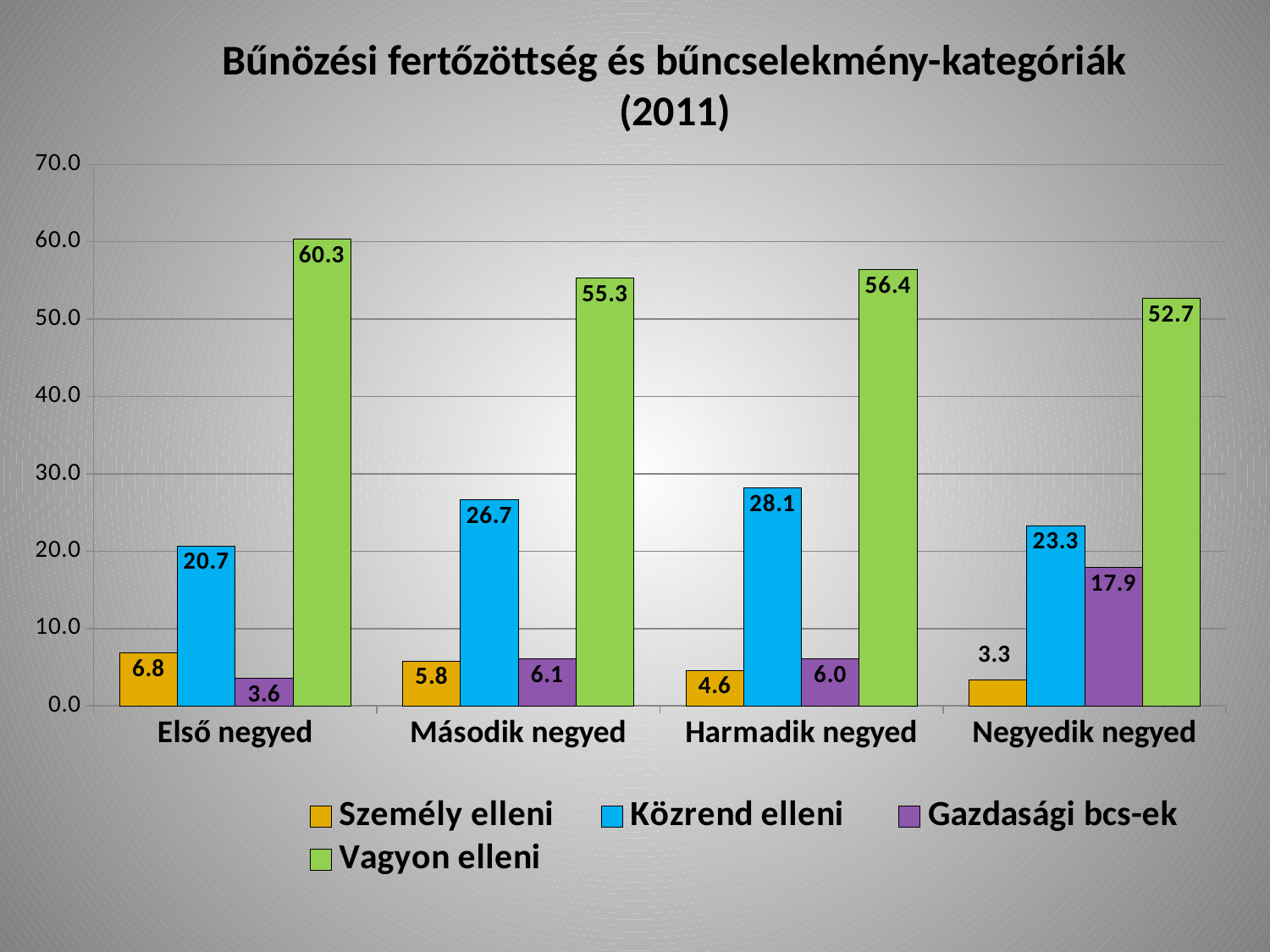
What is the value for Gazdasági bcs-ek in Negyedik negyed? 17.9 How many series does the legend list? 4 In which quarter is the Személy elleni value lowest? Negyedik negyed Which is larger: Közrend elleni in Második negyed or Közrend elleni in Negyedik negyed? Második negyed What is the value for Közrend elleni in Harmadik negyed? 28.1 Which series is shown in green? Vagyon elleni Is the value for Vagyon elleni in Harmadik negyed greater or less than 50.0? greater What is the value for Vagyon elleni in Első negyed? 60.3 In which quarter is the Vagyon elleni value highest? Első negyed How many quarters (categories) are shown on the x axis? 4 What is the difference between the Vagyon elleni values for Első negyed and Negyedik negyed? 7.6 What kind of chart is shown on the slide? bar chart